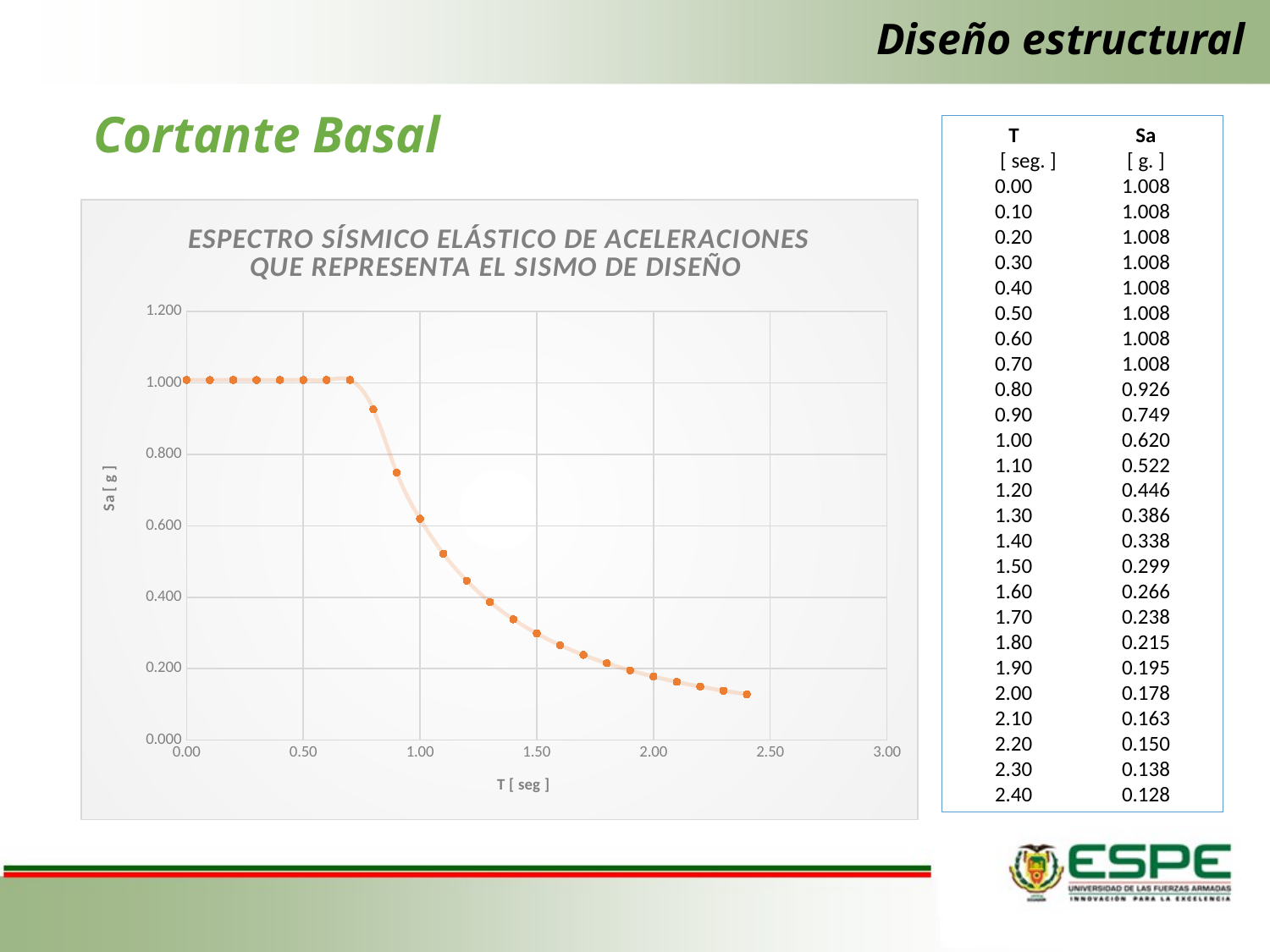
At which value of T is Sa lowest? 2.40 What is the value of Sa at T = 1.00 seg? 0.620 What is the label of the x axis of the chart? T [ seg ] Do the Sa values rise or fall as T increases along the x axis? fall What kind of chart is shown on the slide? scatter chart What is the value of Sa at T = 0.80 seg? 0.926 What is the title of the chart? ESPECTRO SÍSMICO ELÁSTICO DE ACELERACIONES QUE REPRESENTA EL SISMO DE DISEÑO Which has a larger Sa value: T = 0.90 or T = 1.20? T = 0.90 What is the highest Sa value plotted on the chart? 1.008 What is the difference between Sa at T = 1.00 and Sa at T = 2.00? 0.442 How many data points are plotted on the chart? 25 What is the value of Sa at T = 2.40 seg? 0.128